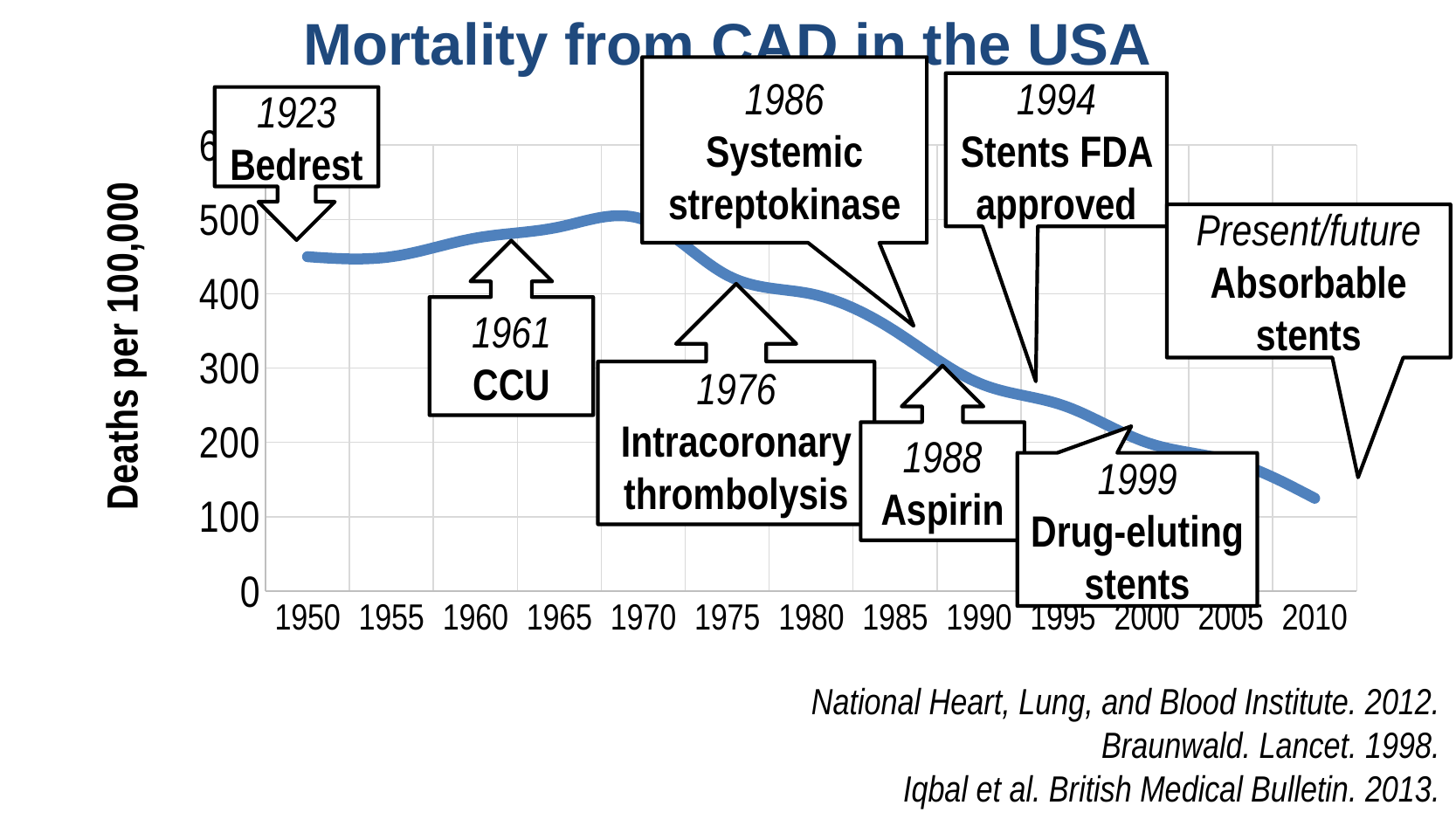
What kind of chart is shown on the slide? line chart Do the values rise or fall along the x axis from 1970 to 2010? fall What is the title of the chart? Mortality from CAD in the USA Is the value for 2010 greater or less than 200? less Is the value for 2005 greater or less than 200? less Is the value for 1950 greater or less than 400? greater Which is larger, the value for 1950 or the value for 2010? 1950 What is the label of the y axis? Deaths per 100,000 Which is larger, the value for 1970 or the value for 1990? 1970